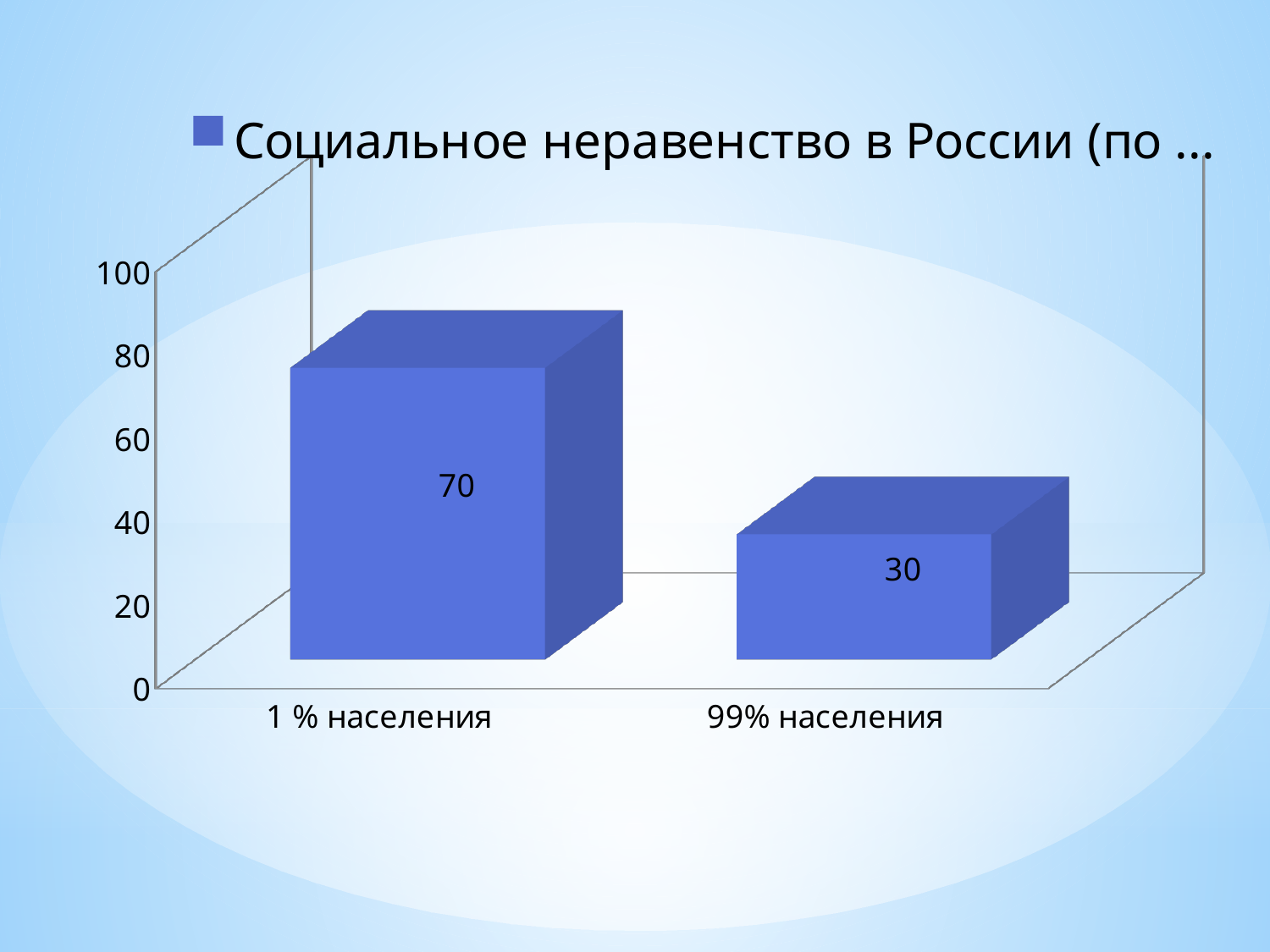
Is the value for "1 % населения" greater or less than 60? greater How many categories are shown on the chart? 2 What is the value for "99% населения"? 30 What colour are the bars in the chart? blue Which category has the highest value? 1 % населения What is the value for "1 % населения"? 70 Is the value for "99% населения" greater or less than 40? less Which category has the lowest value? 99% населения What is the difference between the values for "1 % населения" and "99% населения"? 40 Which is larger, the value for "1 % населения" or for "99% населения"? 1 % населения What is the maximum value shown on the vertical axis? 100 What kind of chart is shown on the slide? bar chart